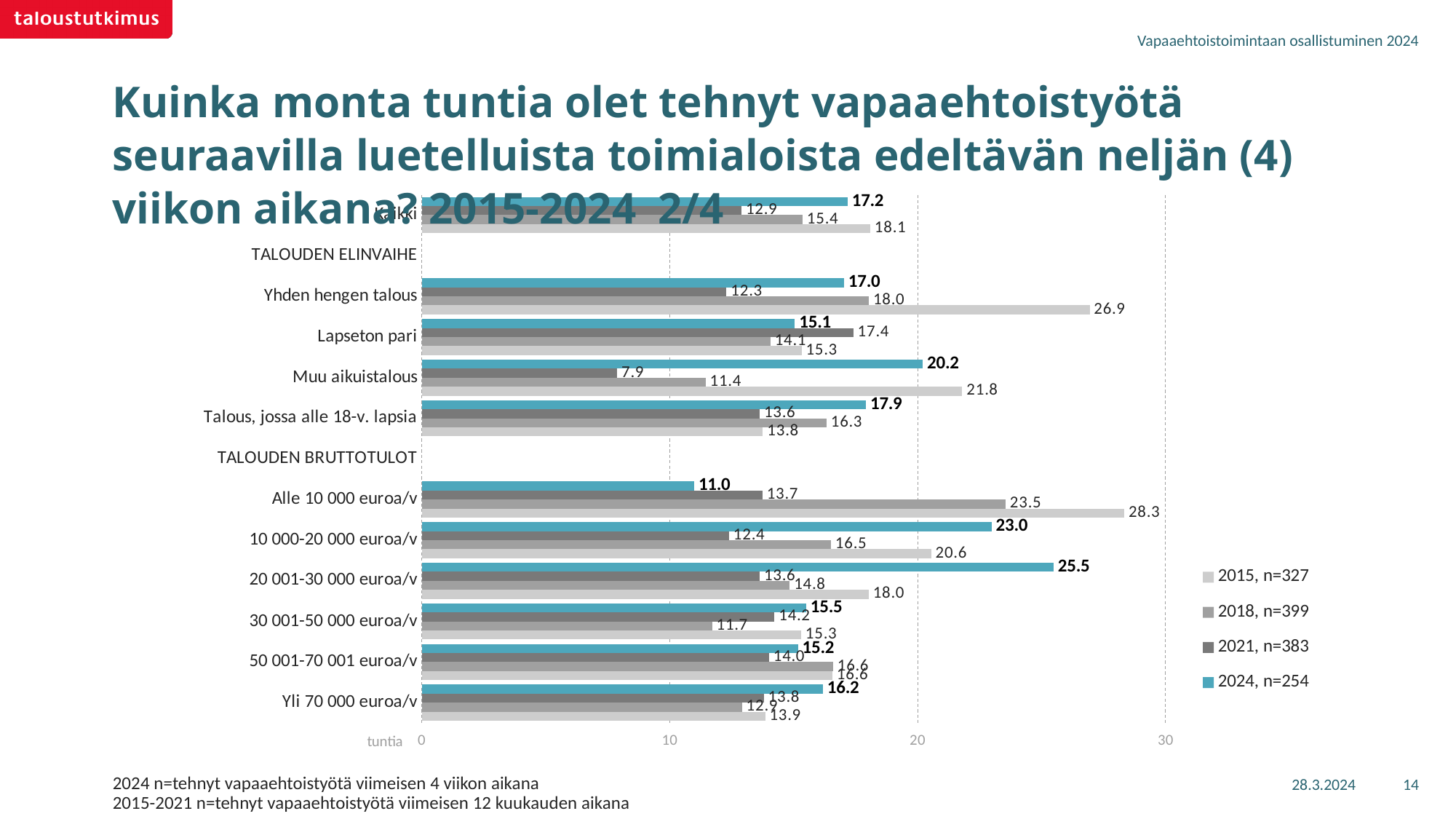
What kind of chart is shown on the slide? bar chart What is the 2024 value for 20 001-30 000 euroa/v? 25.5 Is the 2024 value for 10 000-20 000 euroa/v greater or less than 20? greater Which category has the lowest 2024 value? Alle 10 000 euroa/v What is the 2024 value for Kaikki? 17.2 Which category has the highest 2024 value? 20 001-30 000 euroa/v Which is larger, the 2024 value for Muu aikuistalous or the 2024 value for Lapseton pari? Muu aikuistalous What is the difference between the highest and lowest 2024 values (20 001-30 000 euroa/v and Alle 10 000 euroa/v)? 14.5 How many series does the legend list? 4 What label is shown on the horizontal axis of the chart? tuntia What is the 2015 value for Yhden hengen talous? 26.9 What is the 2024 value for Muu aikuistalous? 20.2